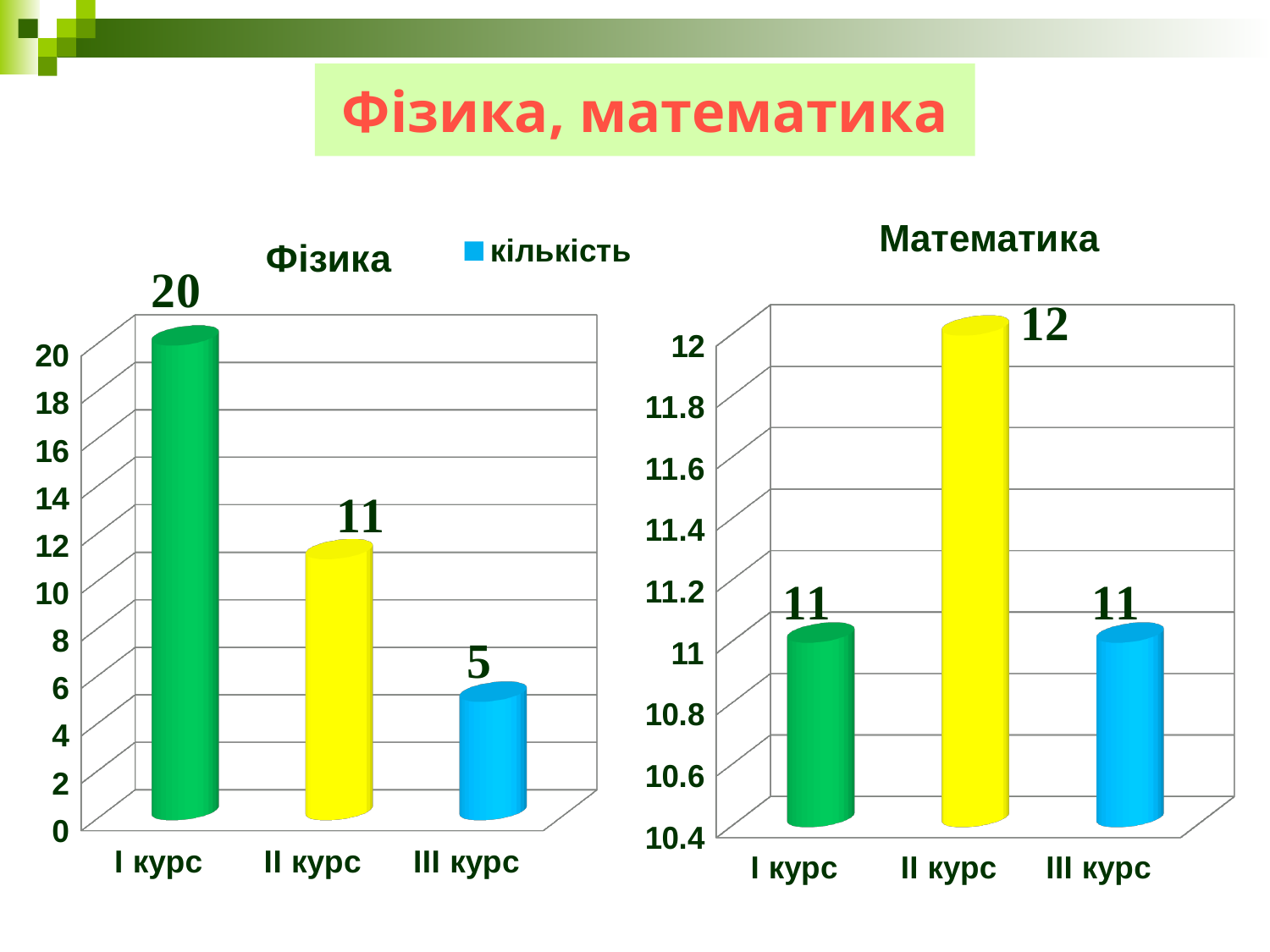
In the Фізика chart, what is the difference between the values for I курс and II курс? 9 In the Математика chart, what is the value for II курс? 12 In the Математика chart, what is the difference between the values for II курс and I курс? 1 In the Фізика chart, which course has the lowest value? III курс In the Фізика chart, which is larger: the value for II курс or III курс? II курс In the Математика chart, which course has the highest value? II курс In the Фізика chart, do the values rise or fall from I курс to III курс? fall In the Фізика chart, which course has the highest value? I курс In the Фізика chart, what is the value for I курс? 20 In the Фізика chart, what is the value for III курс? 5 What kind of chart is the Фізика chart? bar chart How many courses are shown in the Математика chart? 3